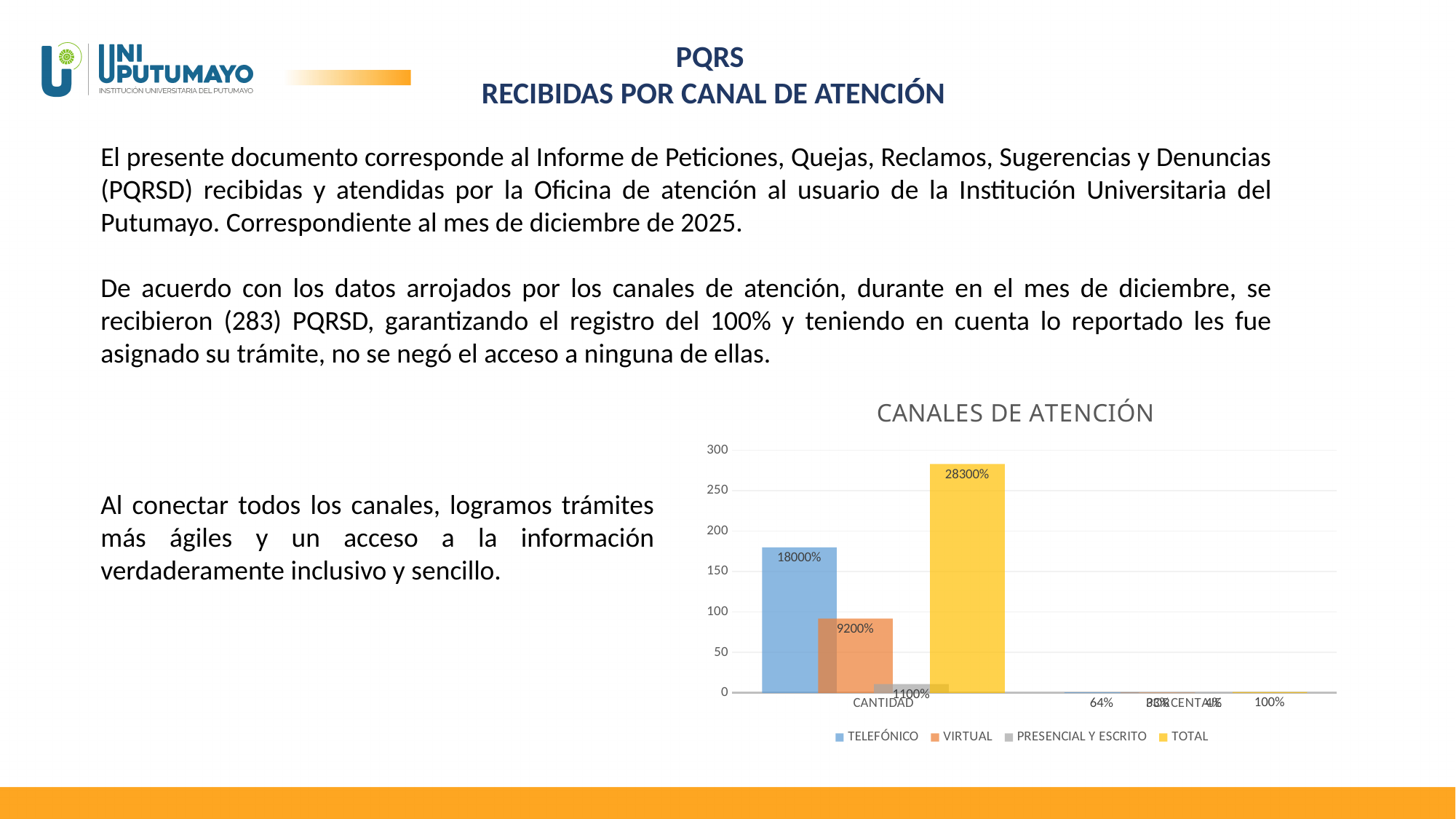
Is the TELEFÓNICO bar for CANTIDAD greater or less than 150 on the axis of the CANALES DE ATENCIÓN chart? greater What is the data label on the PRESENCIAL Y ESCRITO bar for CANTIDAD in the CANALES DE ATENCIÓN chart? 1100% Which series has the tallest bar for CANTIDAD in the CANALES DE ATENCIÓN chart? TOTAL How many series does the legend of the CANALES DE ATENCIÓN chart list? 4 What is the data label on the VIRTUAL bar for CANTIDAD in the CANALES DE ATENCIÓN chart? 9200% What is the data label shown for TELEFÓNICO under PORCENTAJE in the CANALES DE ATENCIÓN chart? 64% What is the data label on the TOTAL bar for CANTIDAD in the CANALES DE ATENCIÓN chart? 28300% What kind of chart is the CANALES DE ATENCIÓN chart? bar chart Which series has the shortest bar for CANTIDAD in the CANALES DE ATENCIÓN chart? PRESENCIAL Y ESCRITO What is the data label on the TELEFÓNICO bar for CANTIDAD in the CANALES DE ATENCIÓN chart? 18000% How many categories are shown on the x axis of the CANALES DE ATENCIÓN chart? 2 For CANTIDAD, which bar is taller in the CANALES DE ATENCIÓN chart: TELEFÓNICO or VIRTUAL? TELEFÓNICO